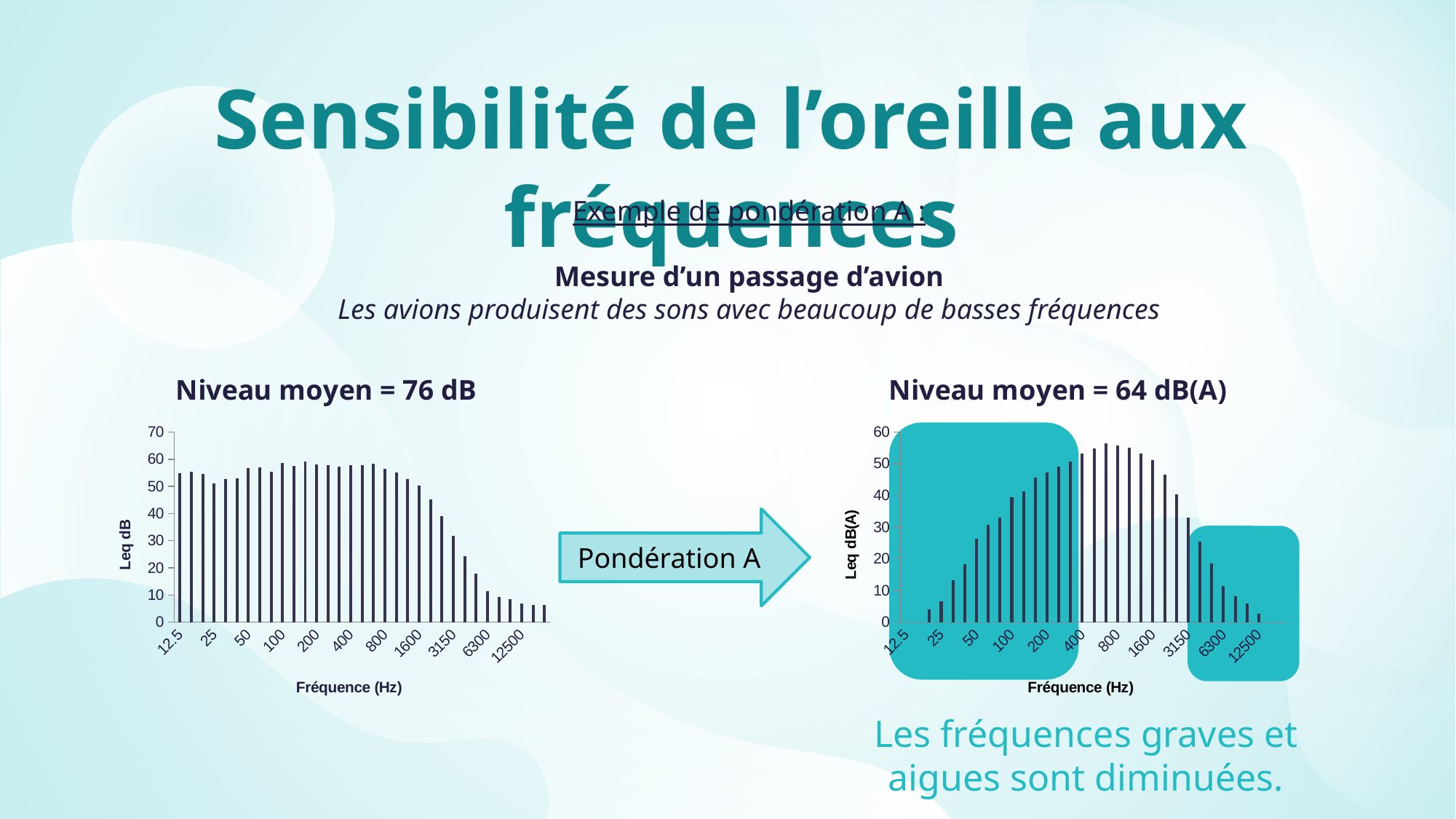
In the right chart (Niveau moyen = 64 dB(A)), is the value for 12.5 Hz greater or less than 10? less In the left chart (Niveau moyen = 76 dB), is the value for 12500 Hz greater or less than 10? less How many frequency tick labels are shown on the x axis of the left chart (Niveau moyen = 76 dB)? 11 In the right chart (Niveau moyen = 64 dB(A)), do the values rise or fall along the x axis from 12.5 Hz to 800 Hz? rise In the right chart (Niveau moyen = 64 dB(A)), is the value for 200 Hz greater or less than 40? greater In the left chart (Niveau moyen = 76 dB), do the values rise or fall along the x axis from 800 Hz to 12500 Hz? fall What is the y-axis title of the right chart (Niveau moyen = 64 dB(A))? Leq dB(A) What kind of chart is the left chart titled 'Niveau moyen = 76 dB'? bar chart In the right chart (Niveau moyen = 64 dB(A)), which of 12.5 Hz or 400 Hz has the larger value? 400 Hz